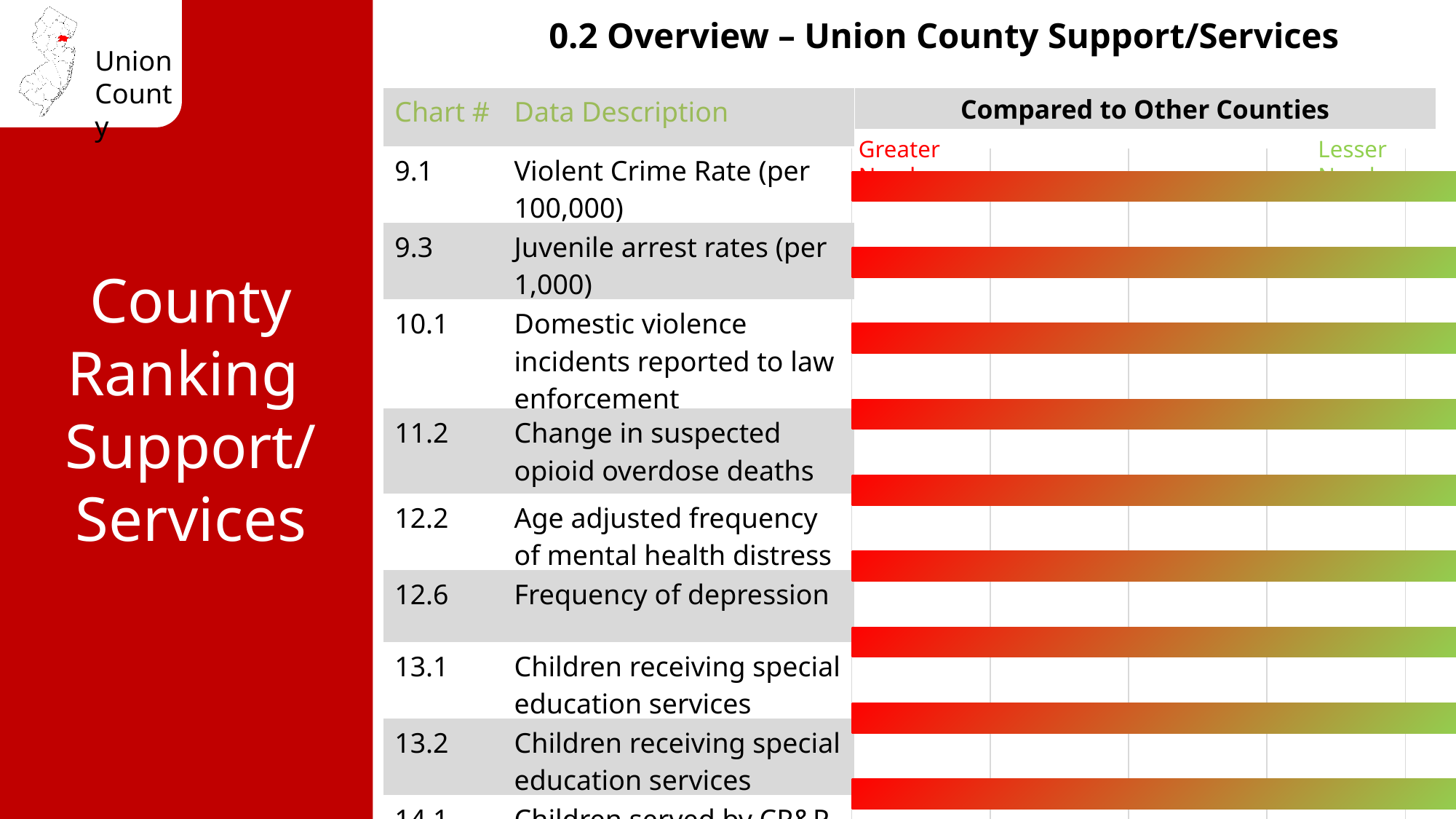
What kind of chart is shown in the 'Compared to Other Counties' column? bar chart Which colour appears at the left end of each bar in the 'Compared to Other Counties' chart? red Which chart number in the table corresponds to 'Violent Crime Rate (per 100,000)'? 9.1 What is the title of the chart column on the right side of the table? Compared to Other Counties How many gradient bars are visible in the 'Compared to Other Counties' chart? 9 Which chart number in the table corresponds to 'Frequency of depression'? 12.6